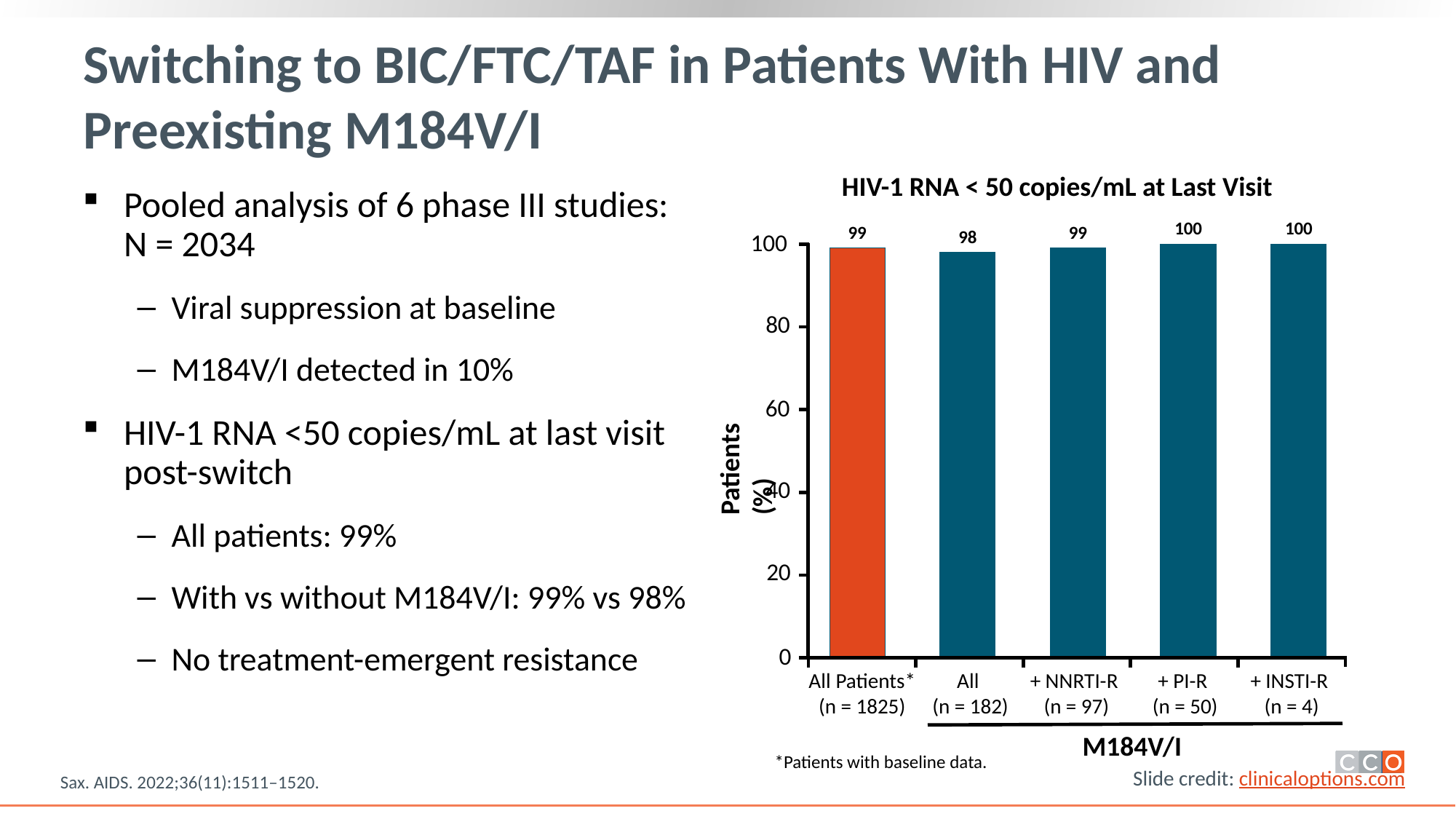
Which category has the lowest value? All (n = 182) Which bar is coloured orange rather than teal? All Patients (n = 1825) What is the difference between the + PI-R value and the M184V/I All (n = 182) value? 2 What is the value for the + INSTI-R (n = 4) group? 100 How many bars are shown in the chart? 5 What is the value for the M184V/I All (n = 182) group? 98 What is the value for the + NNRTI-R (n = 97) group? 99 What is the value for the + PI-R (n = 50) group? 100 What is the value for All Patients (n = 1825)? 99 What kind of chart is shown? Bar chart What is the difference between the All Patients value and the M184V/I All (n = 182) value? 1 What is the title of the chart? HIV-1 RNA < 50 copies/mL at Last Visit